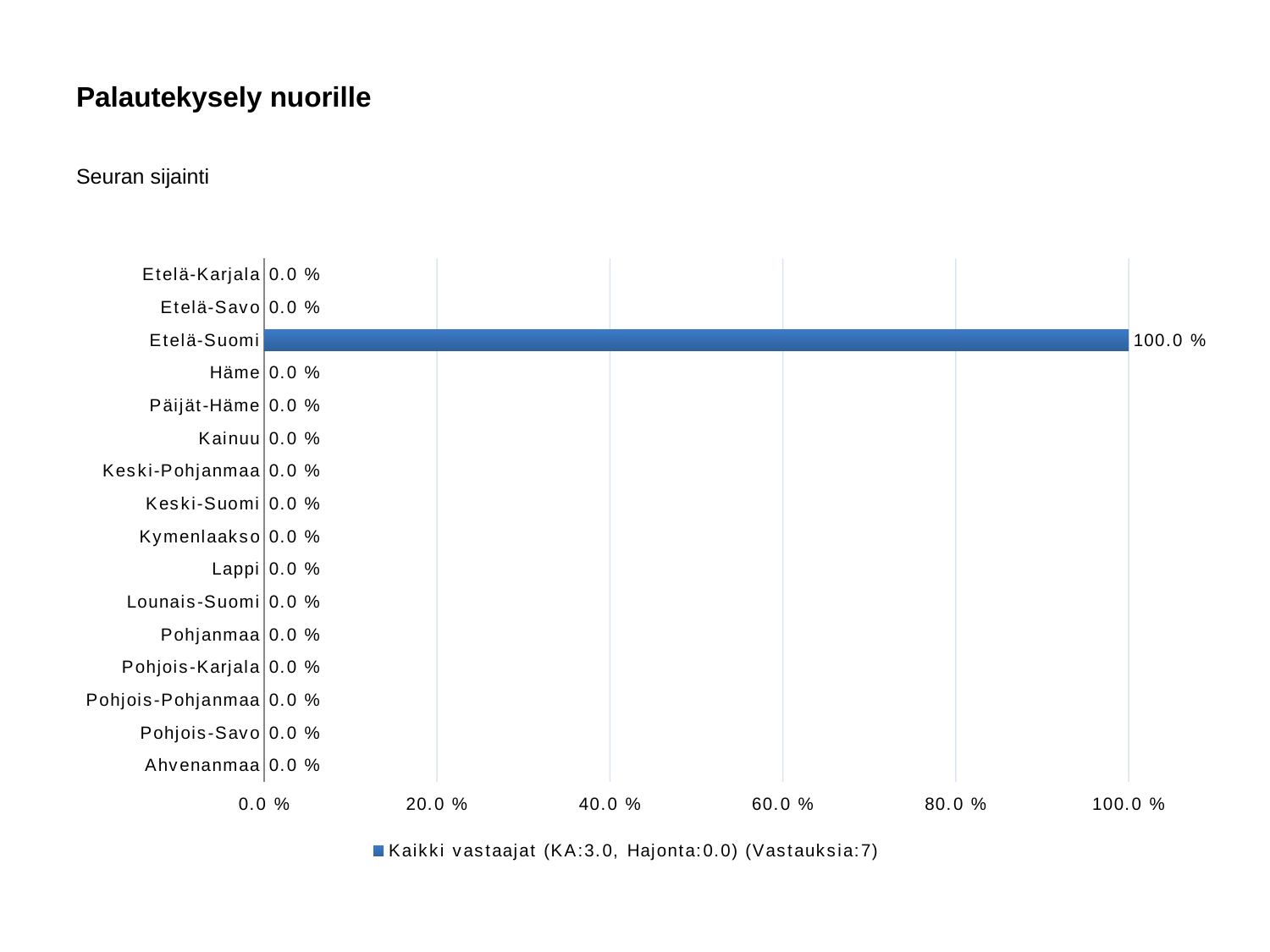
How many categories are shown on the chart? 16 What is the title of the chart? Seuran sijainti What is the value for Etelä-Suomi? 100.0 % What is the difference between the values for Etelä-Suomi and Häme? 100.0 % What is the legend entry for the series? Kaikki vastaajat (KA:3.0, Hajonta:0.0) (Vastauksia:7) What is the value for Pohjois-Pohjanmaa? 0.0 % What kind of chart is shown on the slide? bar chart What is the value for Lappi? 0.0 % How many series does the legend list? 1 Which is larger, the value for Etelä-Suomi or the value for Kainuu? Etelä-Suomi Which category has the highest value? Etelä-Suomi Is the value for Etelä-Suomi greater or less than 80.0 %? greater